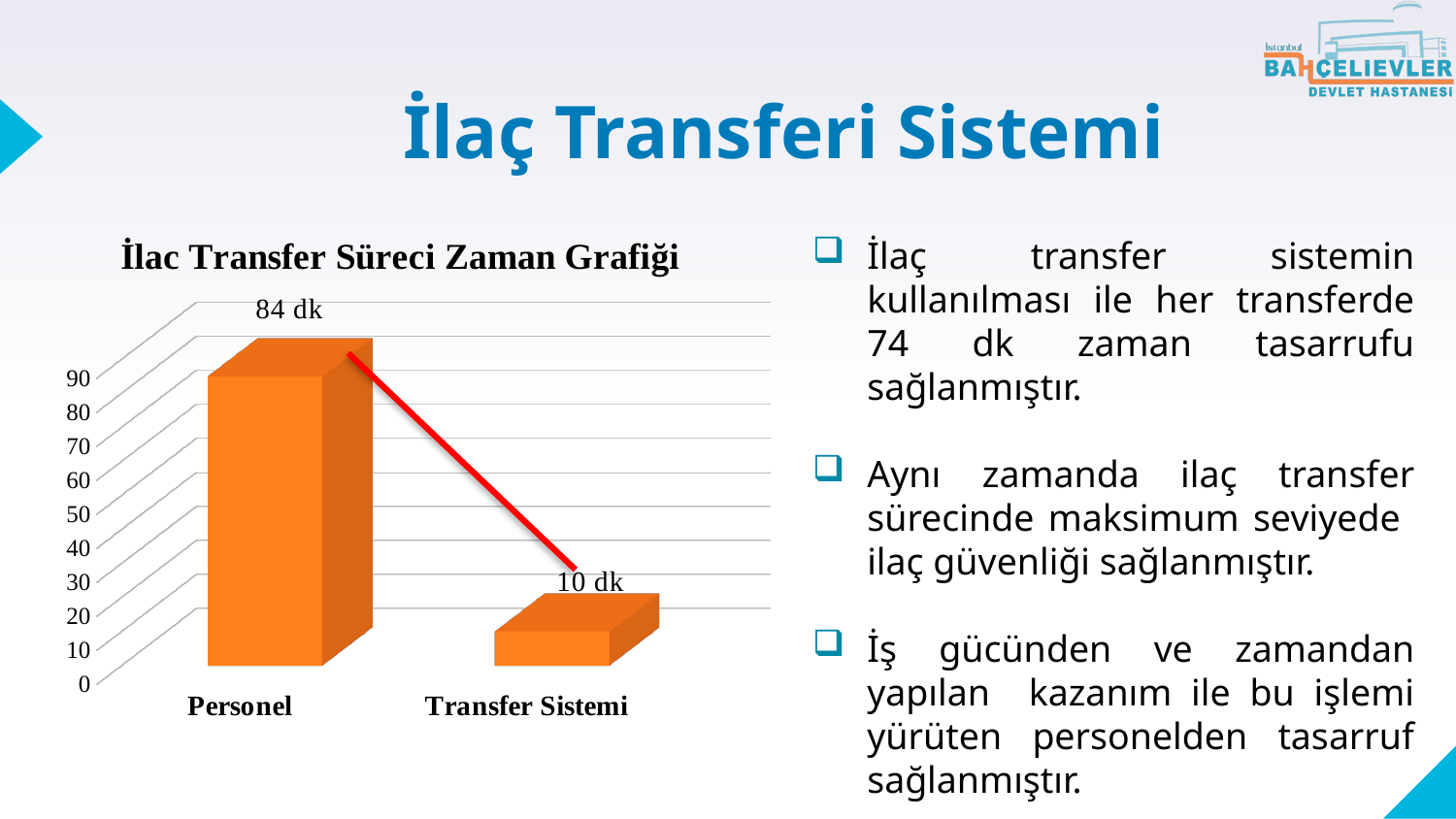
Is the value for Personel greater or less than 50? greater Is the value for Transfer Sistemi greater or less than 30? less What is the difference between the values for Personel and Transfer Sistemi? 74 dk How many categories are shown on the chart? 2 What is the title of the chart? İlac Transfer Süreci Zaman Grafiği Which is larger, the value for Personel or the value for Transfer Sistemi? Personel What is the value for Transfer Sistemi? 10 dk Which category has the highest value? Personel What kind of chart is shown on the slide? bar chart Do the values rise or fall from Personel to Transfer Sistemi? fall Which category has the lowest value? Transfer Sistemi What is the value for Personel? 84 dk